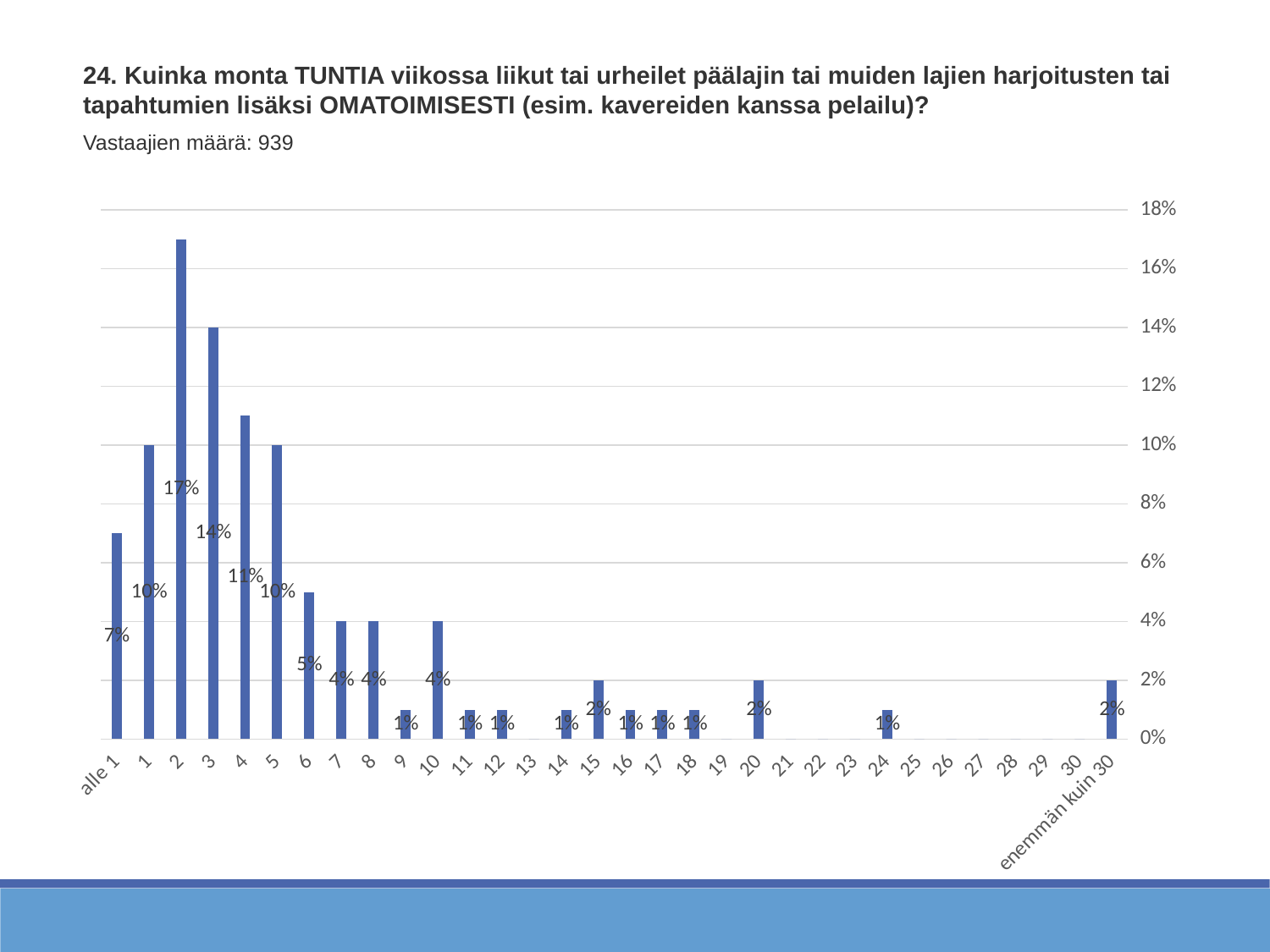
What is the value for the category "enemmän kuin 30"? 2% What is the difference between the values for category 4 and category 10? 7% Which category has the highest value? 2 What is the number of respondents (Vastaajien määrä) stated on the slide? 939 What is the value for category 6? 5% What is the value for category 2? 17% What kind of chart is shown on the slide? bar chart Which is larger, the value for category 15 or the value for category 16? 15 What is the value for the category "alle 1"? 7% Which is larger, the value for category 1 or the value for category 4? 4 What is the difference between the values for category 2 and category 3? 3% How many categories are shown on the x axis? 32